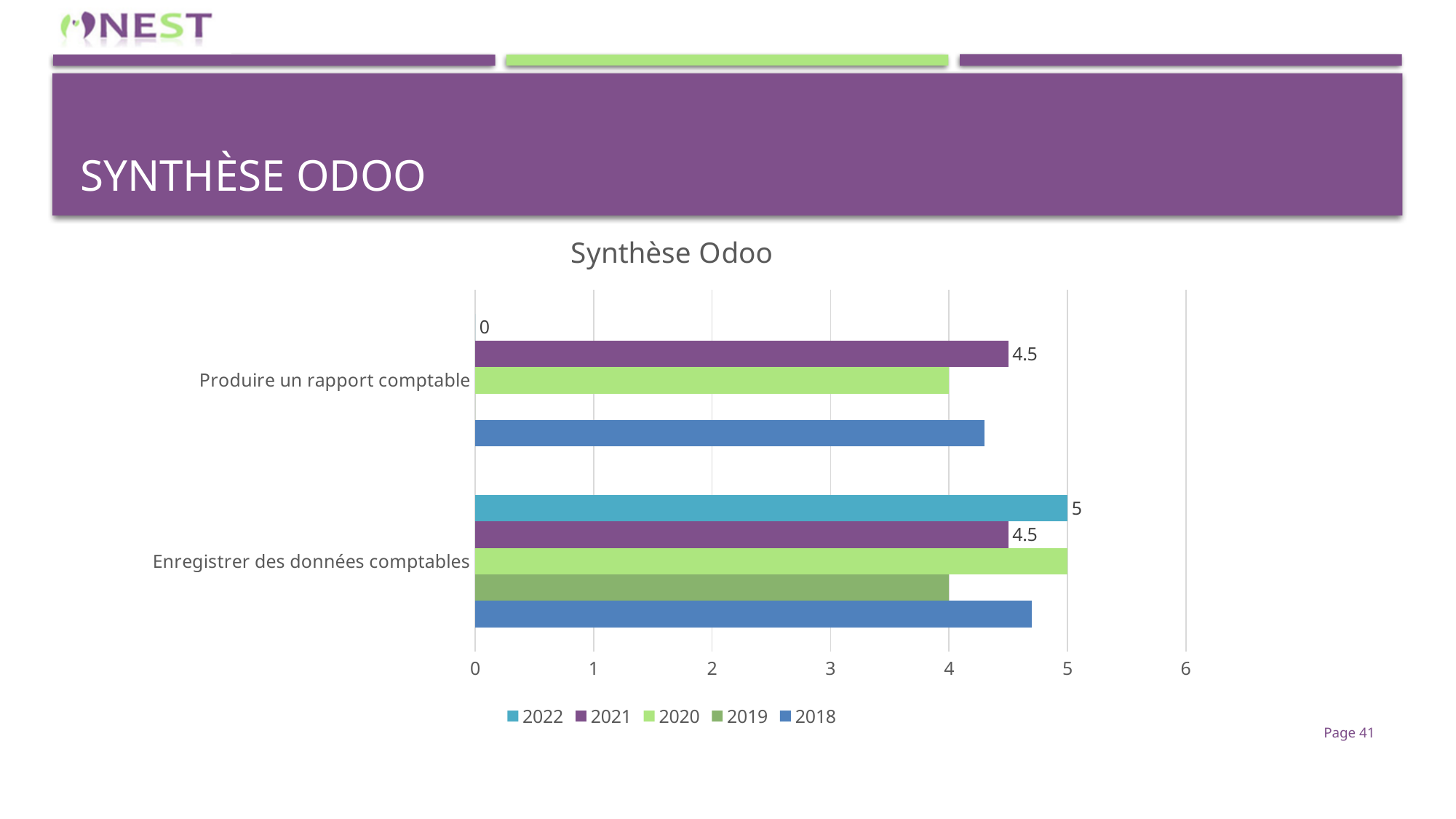
How many series does the legend list? 5 For "Enregistrer des données comptables", which is larger: the value for 2022 or the value for 2021? 2022 What is the value for 2022 for "Enregistrer des données comptables"? 5 What is the value for 2021 for "Enregistrer des données comptables"? 4.5 How many categories are shown on the chart? 2 What is the title of the chart? Synthèse Odoo What is the value for 2022 for "Produire un rapport comptable"? 0 Is the value for 2018 for "Enregistrer des données comptables" greater or less than 5? less What is the difference between the 2022 and 2021 values for "Enregistrer des données comptables"? 0.5 What is the value for 2021 for "Produire un rapport comptable"? 4.5 What kind of chart is shown on the slide? Bar chart What is the value for 2019 for "Enregistrer des données comptables"? 4